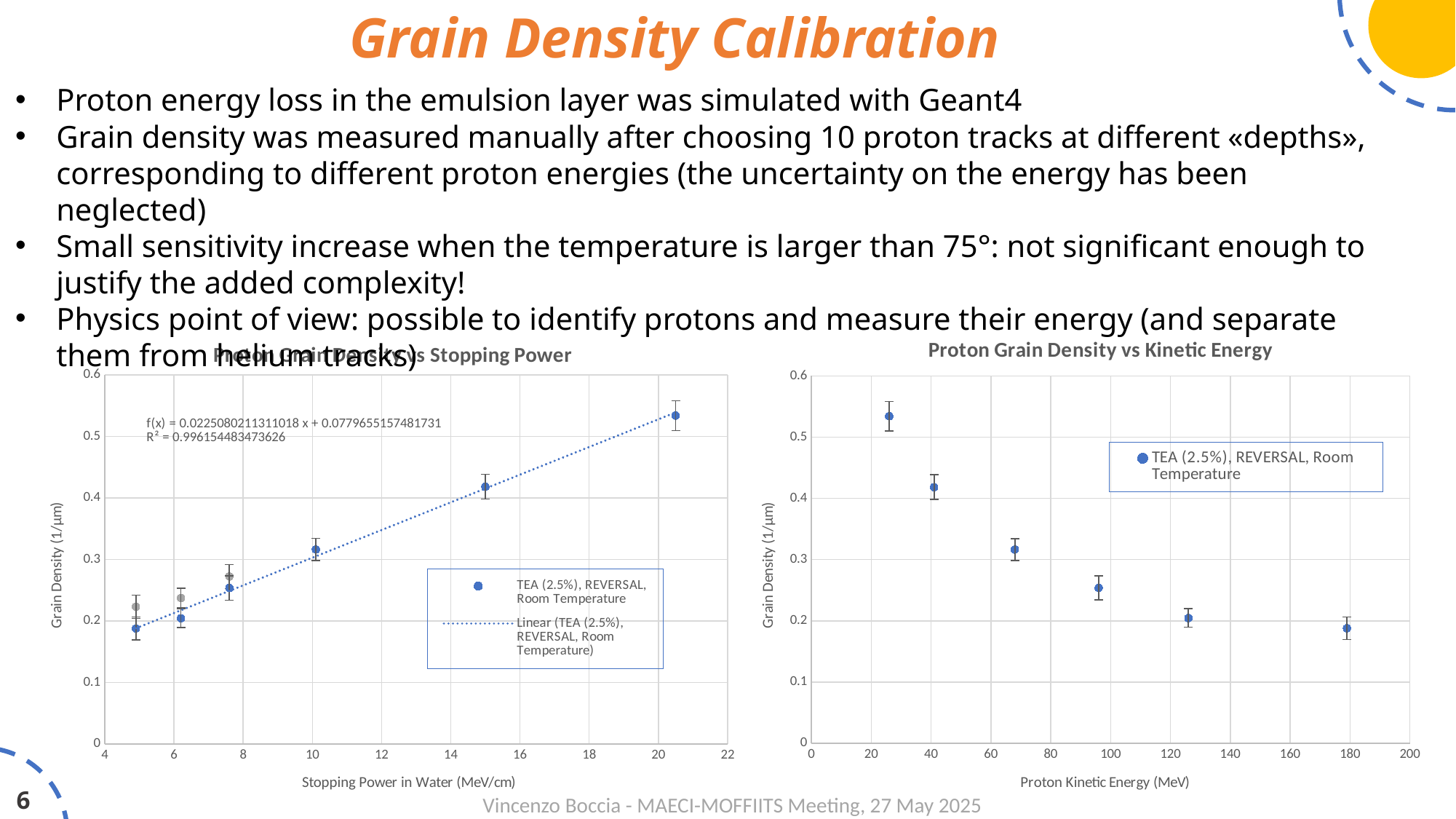
How many entries does the legend of the left chart ('Proton Grain Density vs Stopping Power') list? 2 In the 'Proton Grain Density vs Stopping Power' chart, is the grain density of the point at the highest stopping power greater or less than 0.5? greater How many data points are plotted in the 'Proton Grain Density vs Kinetic Energy' chart? 6 In the 'Proton Grain Density vs Stopping Power' chart on the left, does grain density rise or fall as stopping power increases? Rise What kind of chart is the 'Proton Grain Density vs Kinetic Energy' chart on the right? Scatter chart What R² value is printed on the 'Proton Grain Density vs Stopping Power' chart? 0.996154483473626 What is the x-axis title of the 'Proton Grain Density vs Kinetic Energy' chart? Proton Kinetic Energy (MeV) How many entries does the legend of the right chart ('Proton Grain Density vs Kinetic Energy') list? 1 In the 'Proton Grain Density vs Kinetic Energy' chart, is the grain density of the point near 100 MeV greater or less than 0.3? less In the 'Proton Grain Density vs Kinetic Energy' chart, does grain density rise or fall as proton kinetic energy increases? Fall In the 'Proton Grain Density vs Kinetic Energy' chart, is the grain density of the point at the lowest kinetic energy greater or less than 0.5? greater In the 'Proton Grain Density vs Kinetic Energy' chart, which has the higher grain density: the point at the lowest kinetic energy or the point at the highest kinetic energy? The point at the lowest kinetic energy